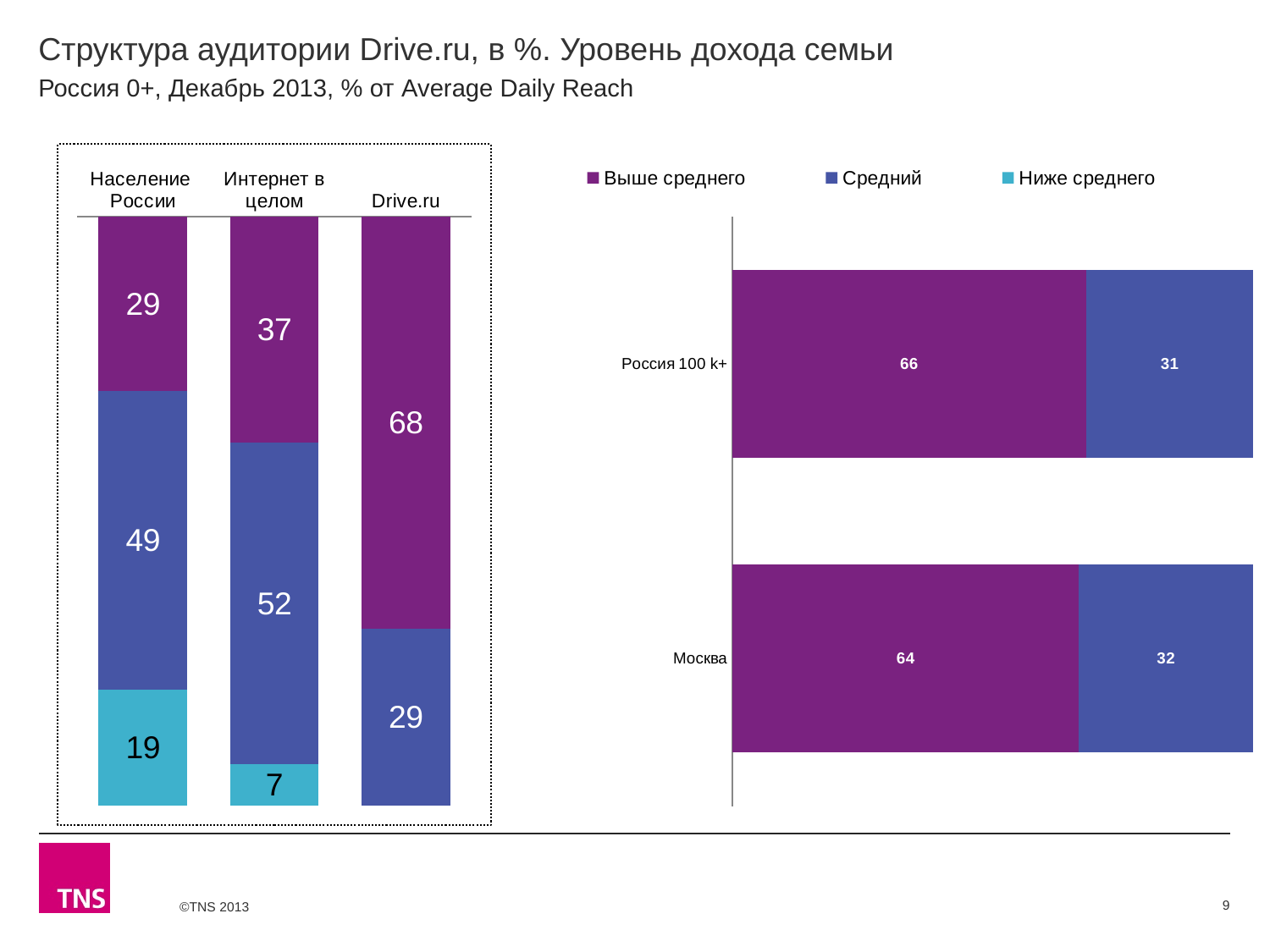
In the right chart, what is the 'Средний' value for Россия 100 k+? 31 How many series does the legend list? 3 In the right chart, which is larger: the 'Выше среднего' value for Россия 100 k+ or for Москва? Россия 100 k+ In the left chart, what is the difference between the 'Выше среднего' values for Drive.ru and Население России? 39 In the left chart, what is the value of the 'Средний' segment for Интернет в целом? 52 In the left chart, what is the total of the stacked bar for Население России? 97 In the left chart, which category has the smallest 'Ниже среднего' segment? Интернет в целом In the left chart, which category has the largest 'Выше среднего' segment? Drive.ru In the left chart, what is the value of the 'Выше среднего' segment for Drive.ru? 68 How many categories are shown in the right chart? 2 In the left chart, what is the value of the 'Ниже среднего' segment for Население России? 19 In the right chart, what is the 'Выше среднего' value for Москва? 64